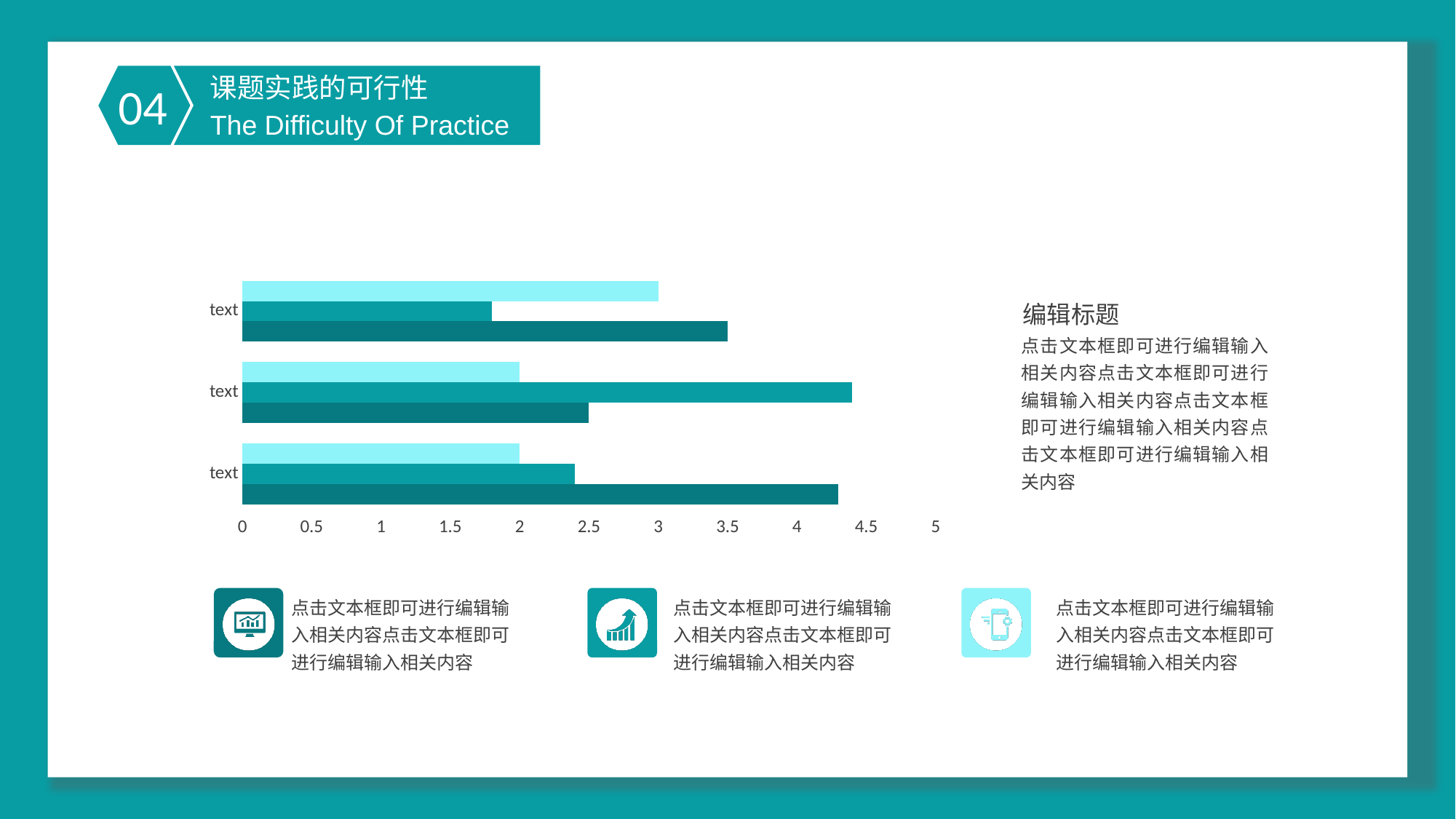
In the middle category group, which bar is the longest: the light cyan, medium teal, or dark teal bar? medium teal In the middle category group, is the value of the medium teal (middle) bar greater or less than 4? greater In the bottom category group, is the value of the dark teal (bottom) bar greater or less than 4? greater In the top category group, which is larger: the light cyan bar or the medium teal bar? light cyan bar What is the highest value shown on the horizontal axis of the chart? 5 In the bottom category group, is the value of the medium teal (middle) bar greater or less than 2? greater How many bars are plotted for each category in the chart? 3 What kind of chart is shown on the slide? bar chart In the top category group, which bar is the longest: the light cyan, medium teal, or dark teal bar? dark teal What is the interval between tick marks on the horizontal axis of the chart? 0.5 How many categories are shown on the vertical axis of the chart? 3